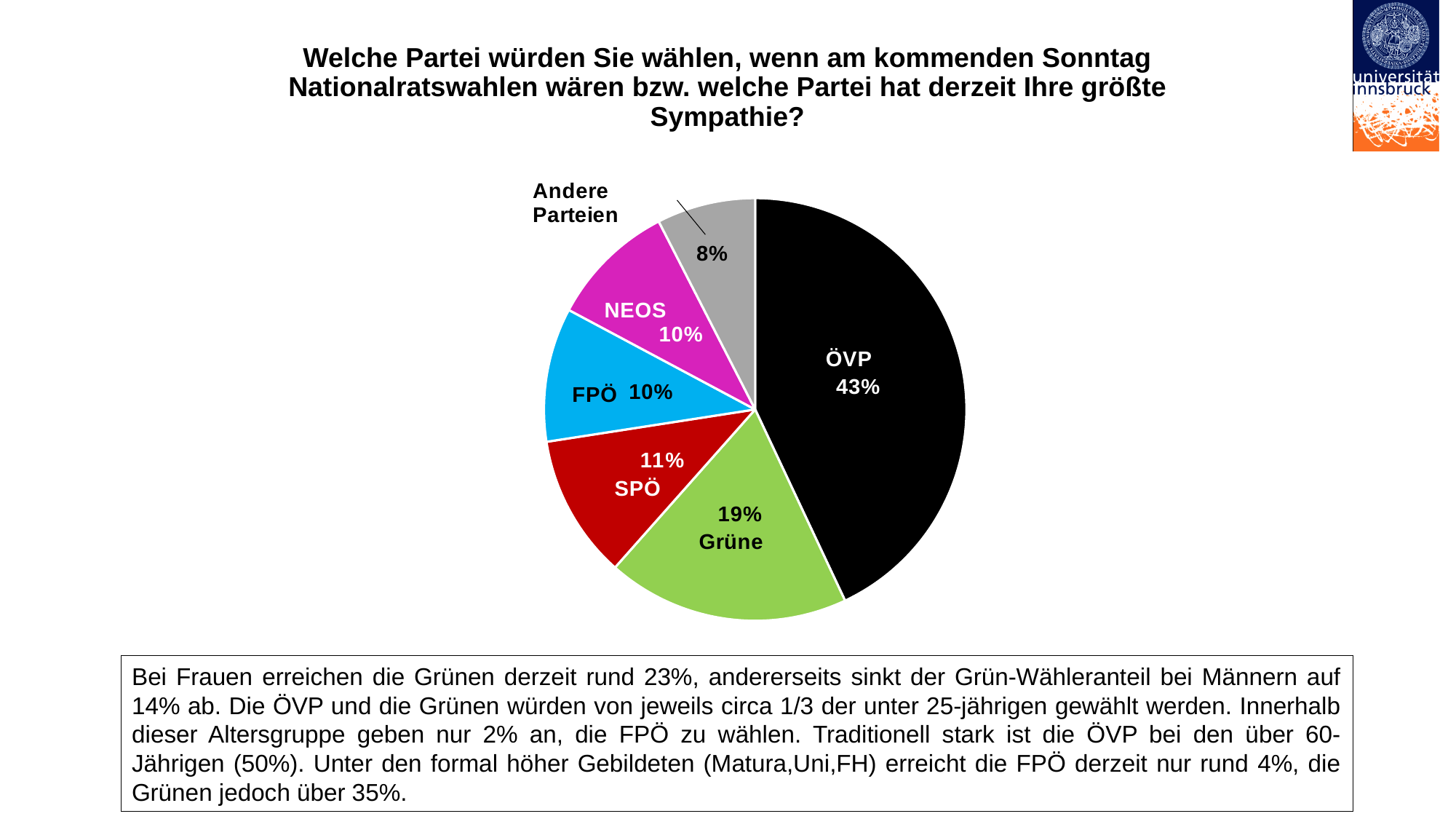
What is the combined share of FPÖ and NEOS? 20% Which party has the largest slice of the pie? ÖVP What is the difference in percentage points between ÖVP and Grüne? 24 What colour is the ÖVP slice? Black Which category has the smallest slice of the pie? Andere Parteien What percentage is shown for Andere Parteien? 8% What value is shown for SPÖ? 11% What percentage is shown for Grüne? 19% What share of the pie does ÖVP hold? 43% Which is larger, the share for SPÖ or the share for FPÖ? SPÖ How many slices does the pie chart have? 6 What kind of chart is shown on the slide? Pie chart